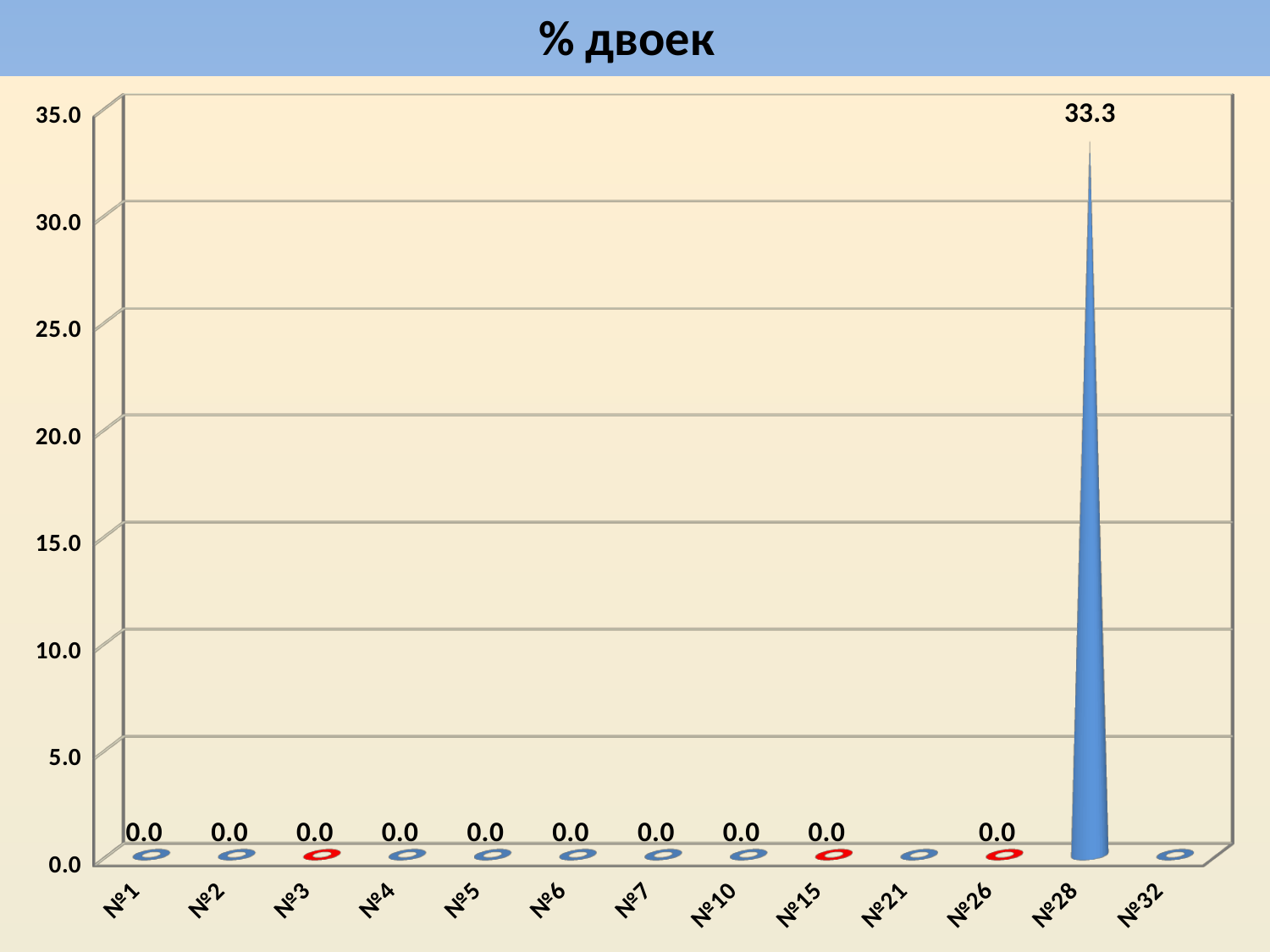
Which is larger, the value for №28 or the value for №7? №28 What is the value for №28? 33.3 What is the title of the chart? % двоек What is the value for №15? 0.0 What is the difference between the values for №28 and №26? 33.3 What is the highest value shown on the y axis? 35.0 Is the value for №28 greater or less than 30.0? greater What kind of chart is this? bar chart How many categories are shown on the x axis? 13 Is the value for №32 greater or less than 5.0? less Which category has the highest value? №28 What is the value for №3? 0.0